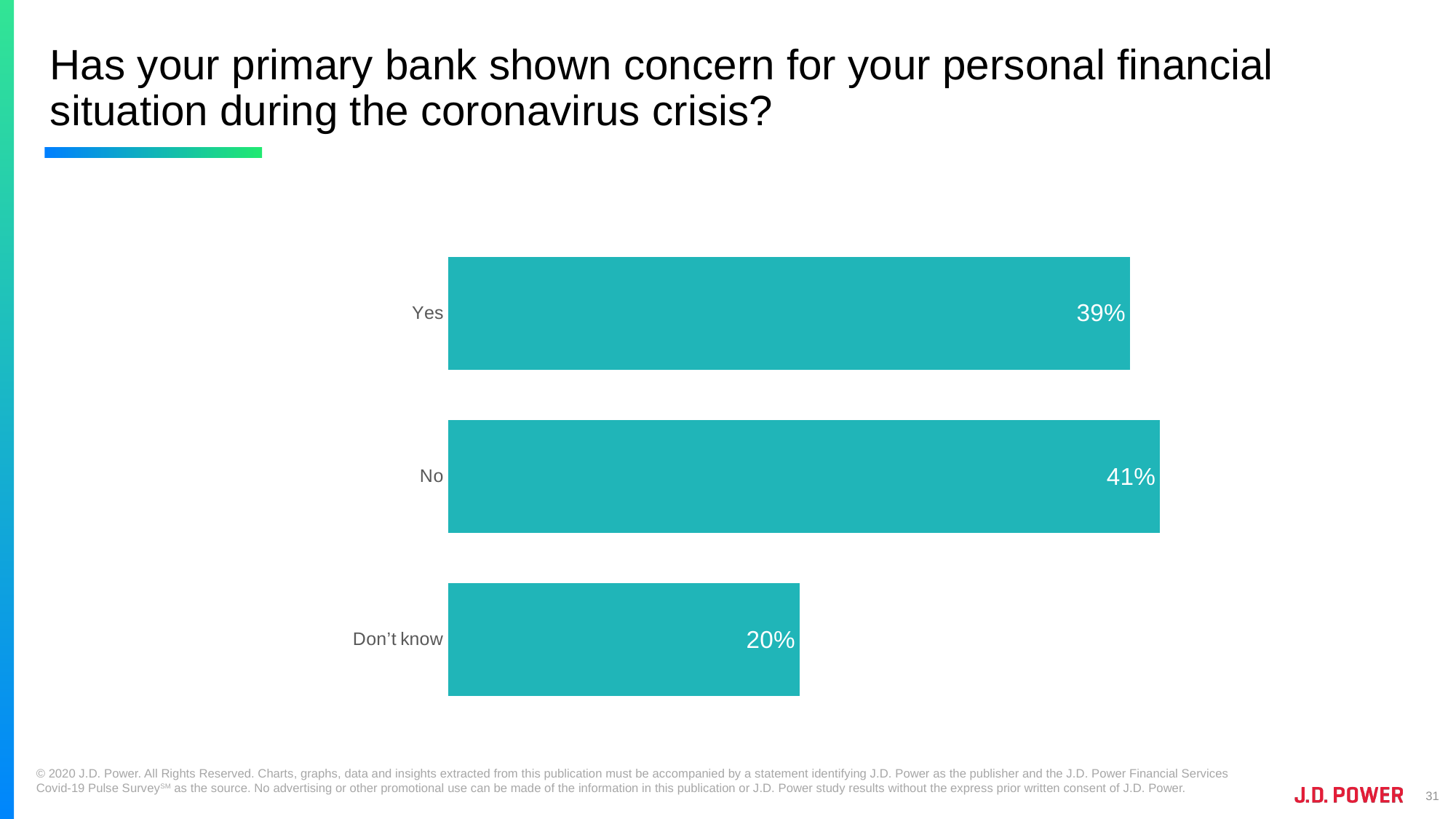
What kind of chart is shown on the slide? Bar chart Which response has the lowest percentage? Don't know What is the combined percentage of "Yes" and "No" responses? 80% Which is larger, the percentage for "Yes" or for "Don't know"? Yes What is the difference in percentage points between "Yes" and "Don't know"? 19 What is the difference in percentage points between "No" and "Yes"? 2 Which response has the highest percentage? No What percentage of respondents answered "Don't know"? 20% What question does the chart title ask? Has your primary bank shown concern for your personal financial situation during the coronavirus crisis? What percentage of respondents answered "No"? 41% How many response categories are shown in the chart? 3 What percentage of respondents answered "Yes"? 39%